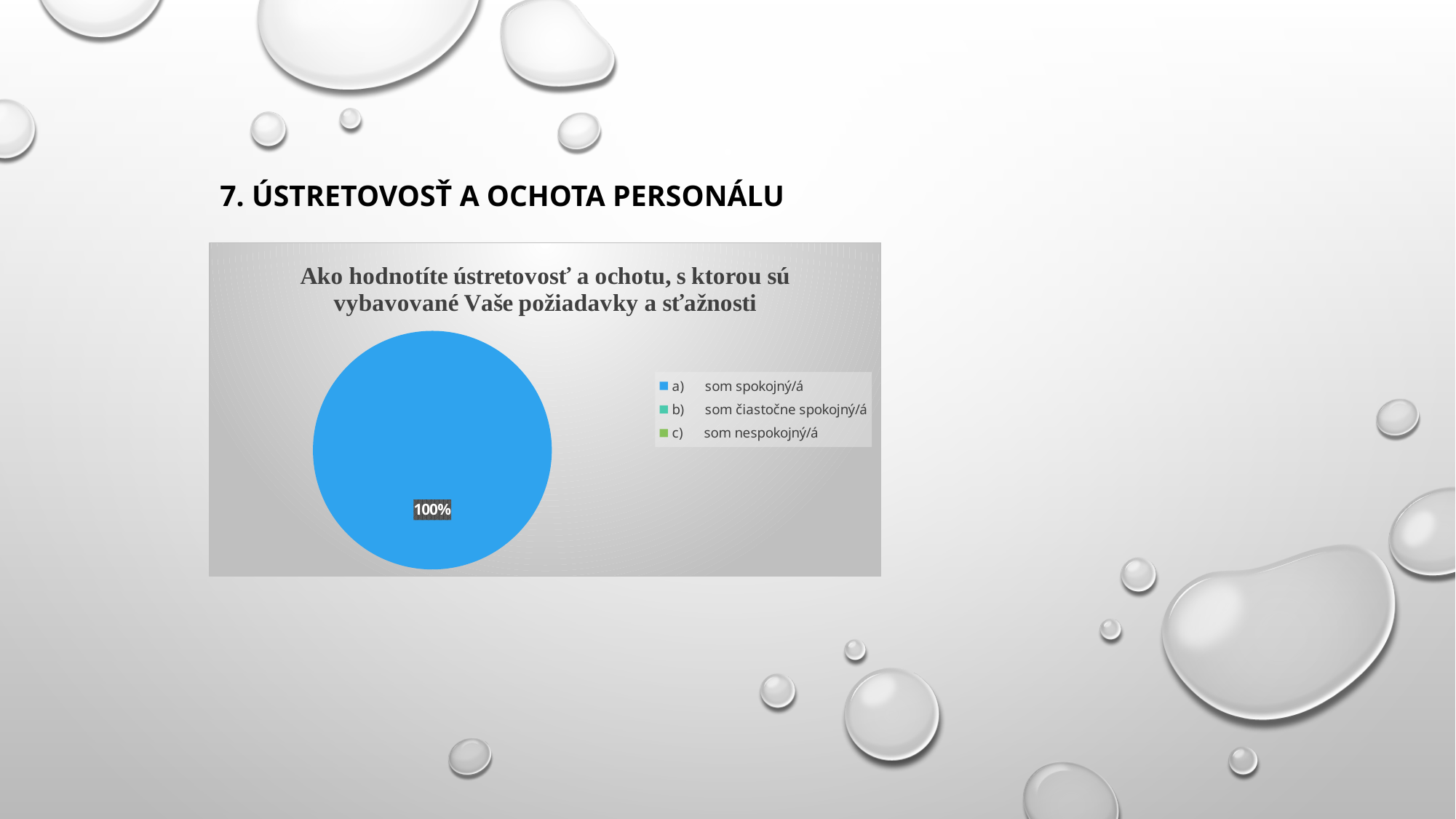
Which legend entry accounts for the entire pie? a) som spokojný/á What kind of chart is shown on the slide? pie chart What is the title of the chart? Ako hodnotíte ústretovosť a ochotu, s ktorou sú vybavované Vaše požiadavky a sťažnosti Which is larger: the share for "a) som spokojný/á" or the share for "c) som nespokojný/á"? a) som spokojný/á What is the data label printed on the pie slice? 100% What share of the pie does "a) som spokojný/á" hold? 100% How many slices are visible in the pie? 1 What colour is the slice representing "a) som spokojný/á"? blue How many entries does the chart's legend list? 3 Is the share for "a) som spokojný/á" greater or less than 50%? greater